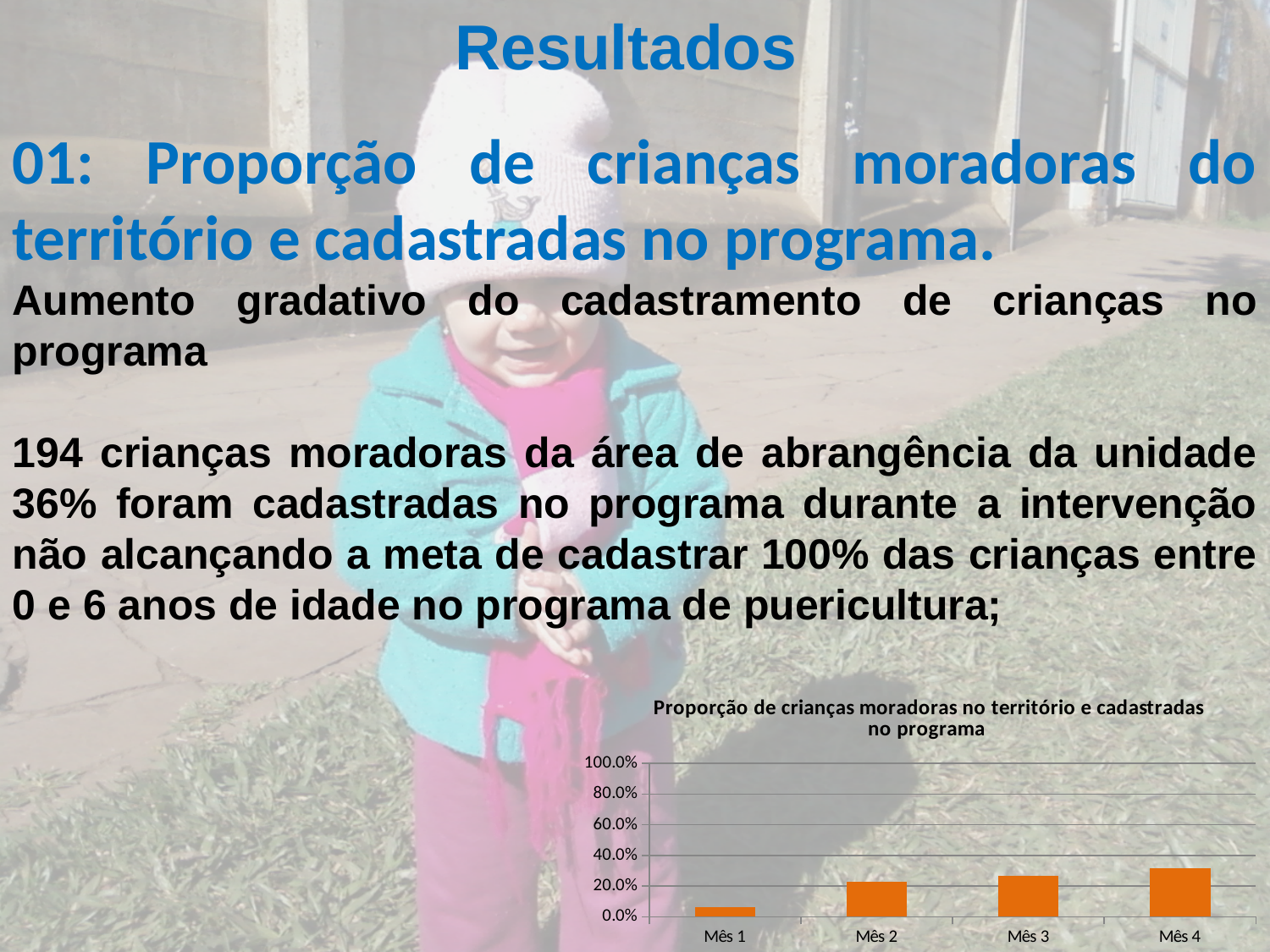
Is the value for Mês 1 greater or less than 20.0%? less Is the value for Mês 4 greater or less than 40.0%? less Which month has the lowest bar in the chart? Mês 1 Which is larger, the value for Mês 1 or the value for Mês 3? Mês 3 Which month has the highest bar in the chart? Mês 4 Do the values rise or fall from Mês 1 to Mês 4? rise What is the title of the chart on the slide? Proporção de crianças moradoras no território e cadastradas no programa Is the value for Mês 4 greater or less than 20.0%? greater Which is larger, the value for Mês 2 or the value for Mês 4? Mês 4 How many categories (months) are plotted on the x axis of the chart? 4 What kind of chart is shown on the slide? bar chart